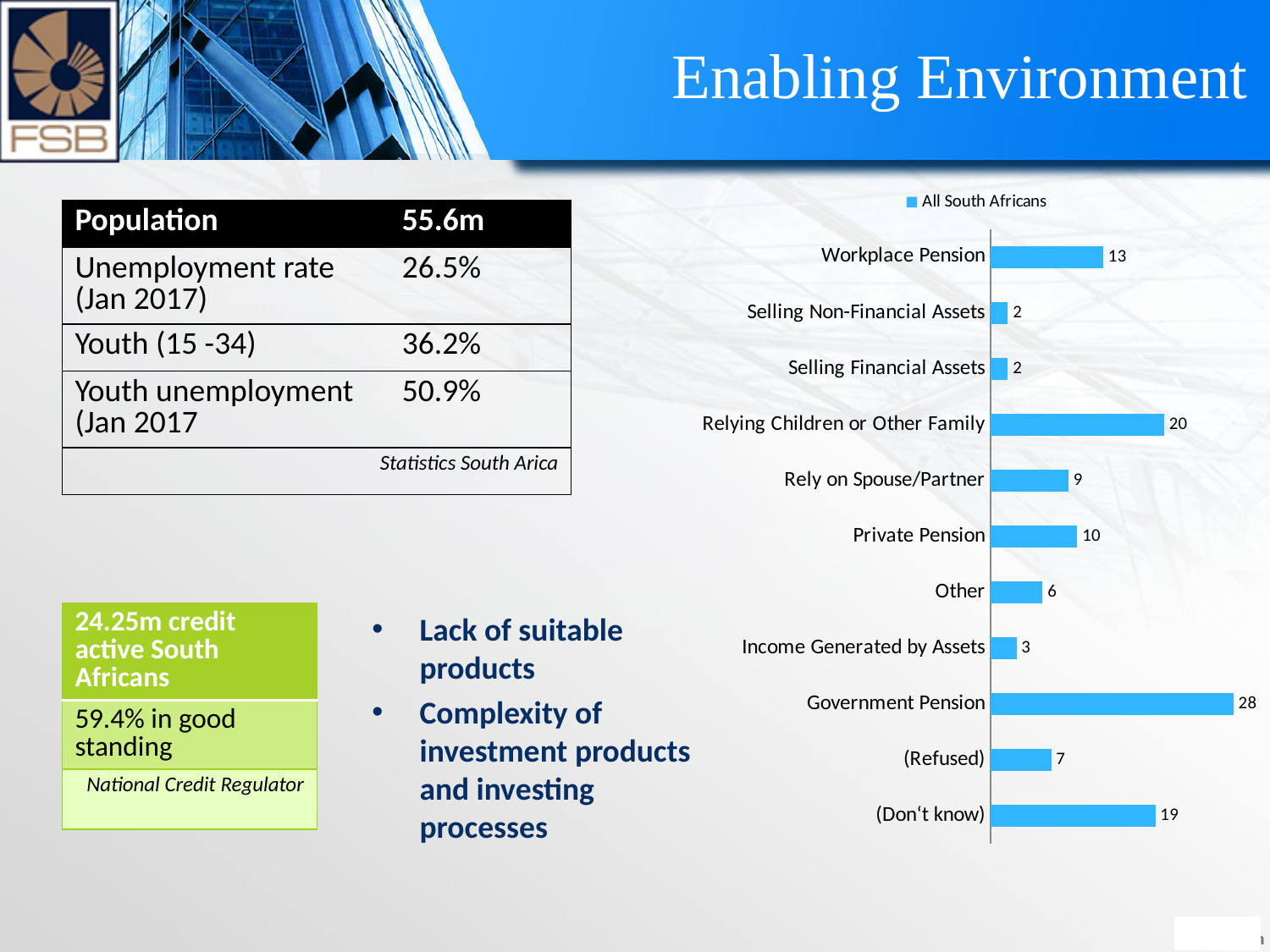
What is the value for Government Pension in the chart? 28 What is the difference between the values for Workplace Pension and Private Pension? 3 What is the value for Relying Children or Other Family in the chart? 20 What series name is shown in the chart legend? All South Africans What is the difference between the values for Government Pension and (Don't know)? 9 What kind of chart is shown on the slide? Bar chart Which category has the highest value in the chart? Government Pension How many categories are shown in the chart? 11 Which is larger in the chart: Private Pension or Rely on Spouse/Partner? Private Pension What is the value for Workplace Pension in the chart? 13 How many series does the chart legend list? 1 What is the value for Income Generated by Assets in the chart? 3